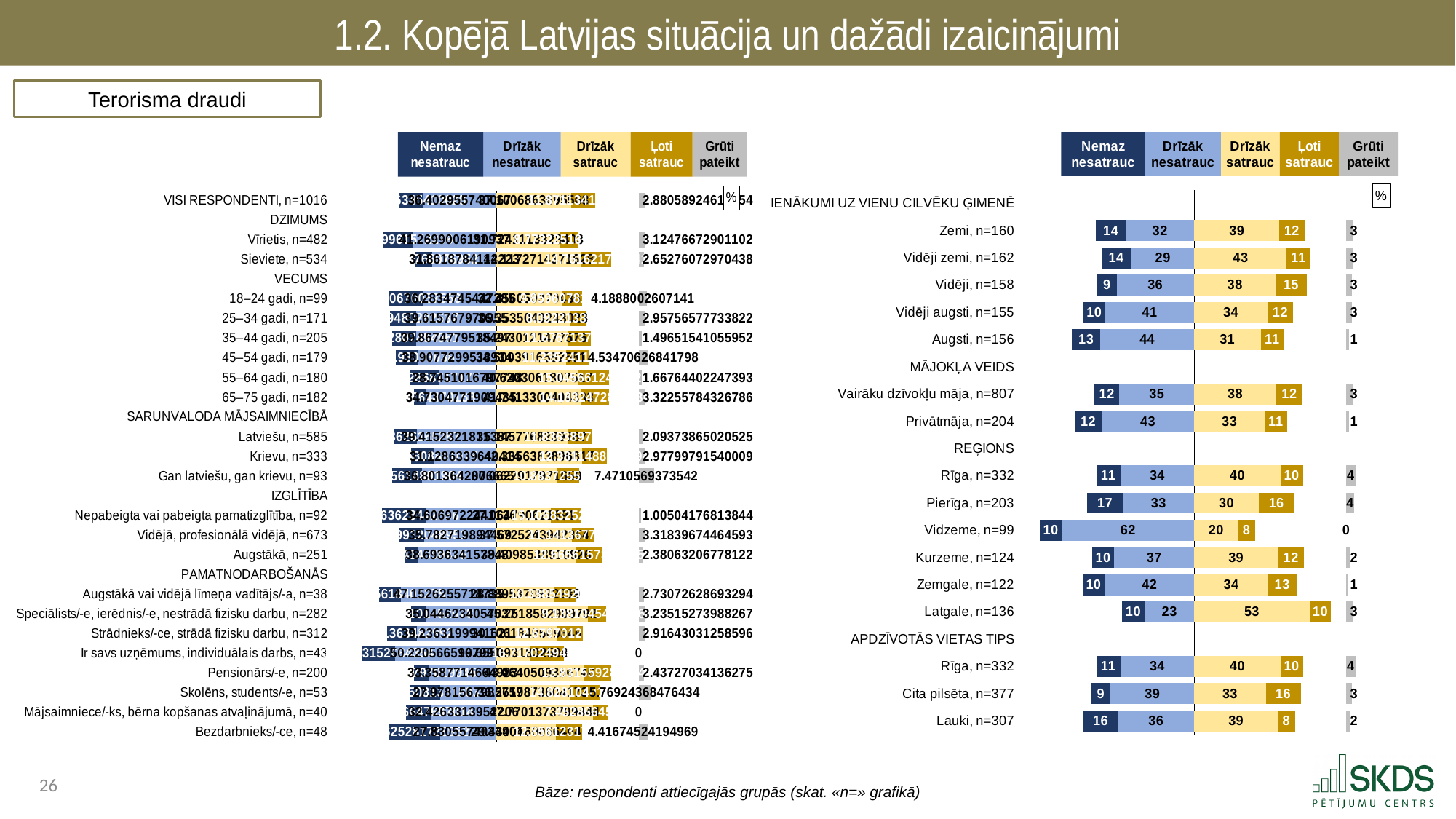
In the right chart, what is the value of "Nemaz nesatrauc" for Lauki, n=307? 16 In the right chart, which has a larger "Drīzāk nesatrauc" value: Privātmāja, n=204 or Vairāku dzīvokļu māja, n=807? Privātmāja, n=204 In the right chart, which income group under IENĀKUMI UZ VIENU CILVĒKU ĢIMENĒ has the lowest "Nemaz nesatrauc" value? Vidēji, n=158 In the right chart, what is the value of "Drīzāk satrauc" for Latgale, n=136? 53 In the right chart, what is the value of "Ļoti satrauc" for Pierīga, n=203? 16 How many series does the legend of the right chart list? 5 In the right chart, what is the value of "Drīzāk nesatrauc" for Vidzeme, n=99? 62 What kind of chart is the right chart? Stacked bar chart In the right chart, what is the total of the stacked bar for Zemi, n=160? 100 In the right chart, which region under REĢIONS has the highest "Drīzāk nesatrauc" value? Vidzeme, n=99 In the right chart, what is the difference between the "Drīzāk satrauc" values for Latgale, n=136 and Vidzeme, n=99? 33 How many categories are shown under REĢIONS in the right chart? 6